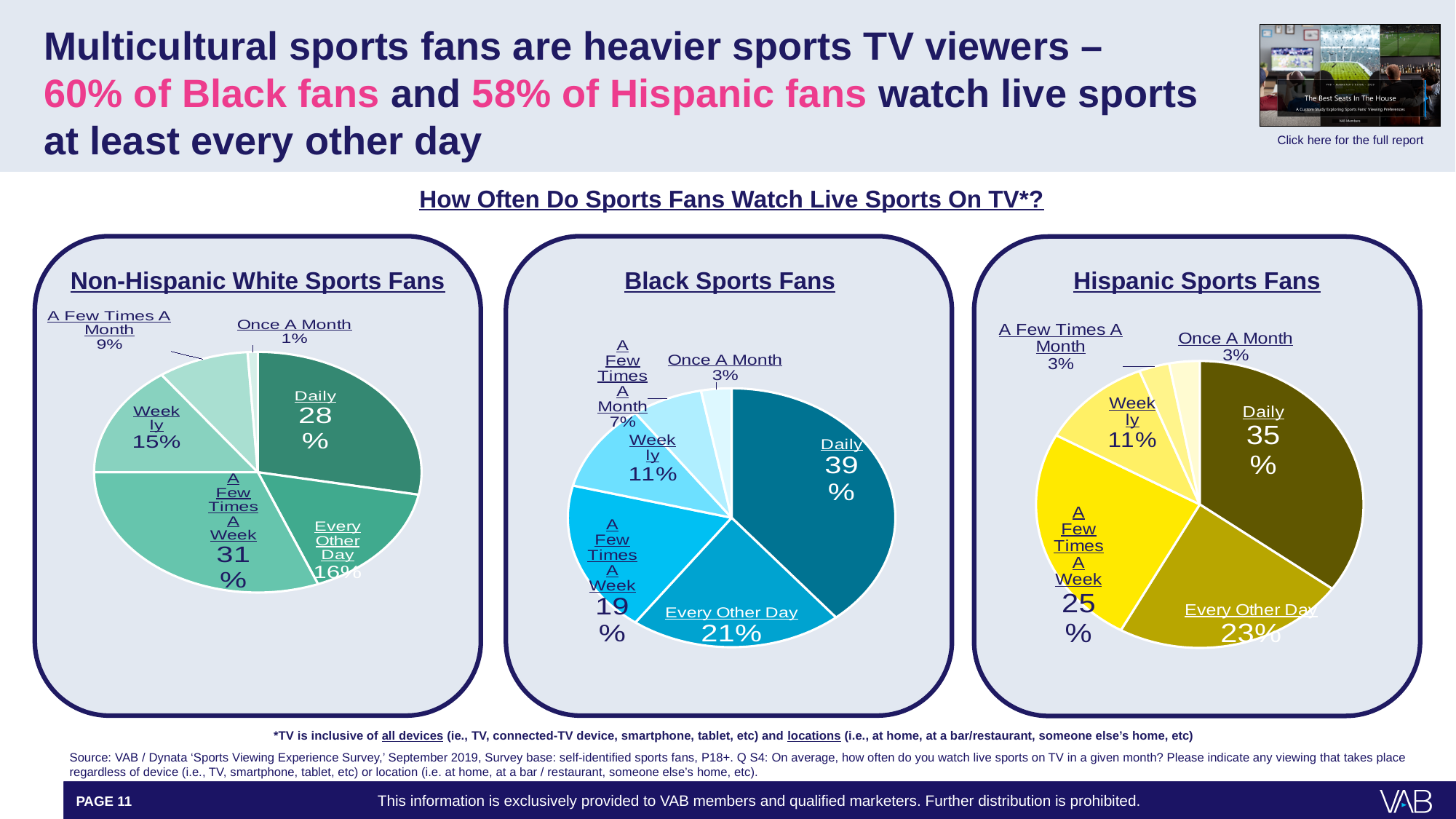
In the Hispanic Sports Fans pie chart, what is the combined share of Daily and Every Other Day? 58% In the Hispanic Sports Fans pie chart, what percentage watch every other day? 23% In the Non-Hispanic White Sports Fans pie chart, which is larger: Weekly or Every Other Day? Every Other Day What is the title shown above the three pie charts? How Often Do Sports Fans Watch Live Sports On TV*? In the Non-Hispanic White Sports Fans pie chart, which category has the smallest slice? Once A Month How many slices does the Hispanic Sports Fans pie chart have? 6 In the Black Sports Fans pie chart, what percentage watch a few times a month? 7% In the Black Sports Fans pie chart, what is the difference between the Daily and Every Other Day percentages? 18% What type of chart is used for the Black Sports Fans data? Pie chart In the Hispanic Sports Fans pie chart, which category has the largest slice? Daily In the Non-Hispanic White Sports Fans pie chart, what percentage watch a few times a week? 31% In the Black Sports Fans pie chart, what share of fans watch live sports on TV daily? 39%